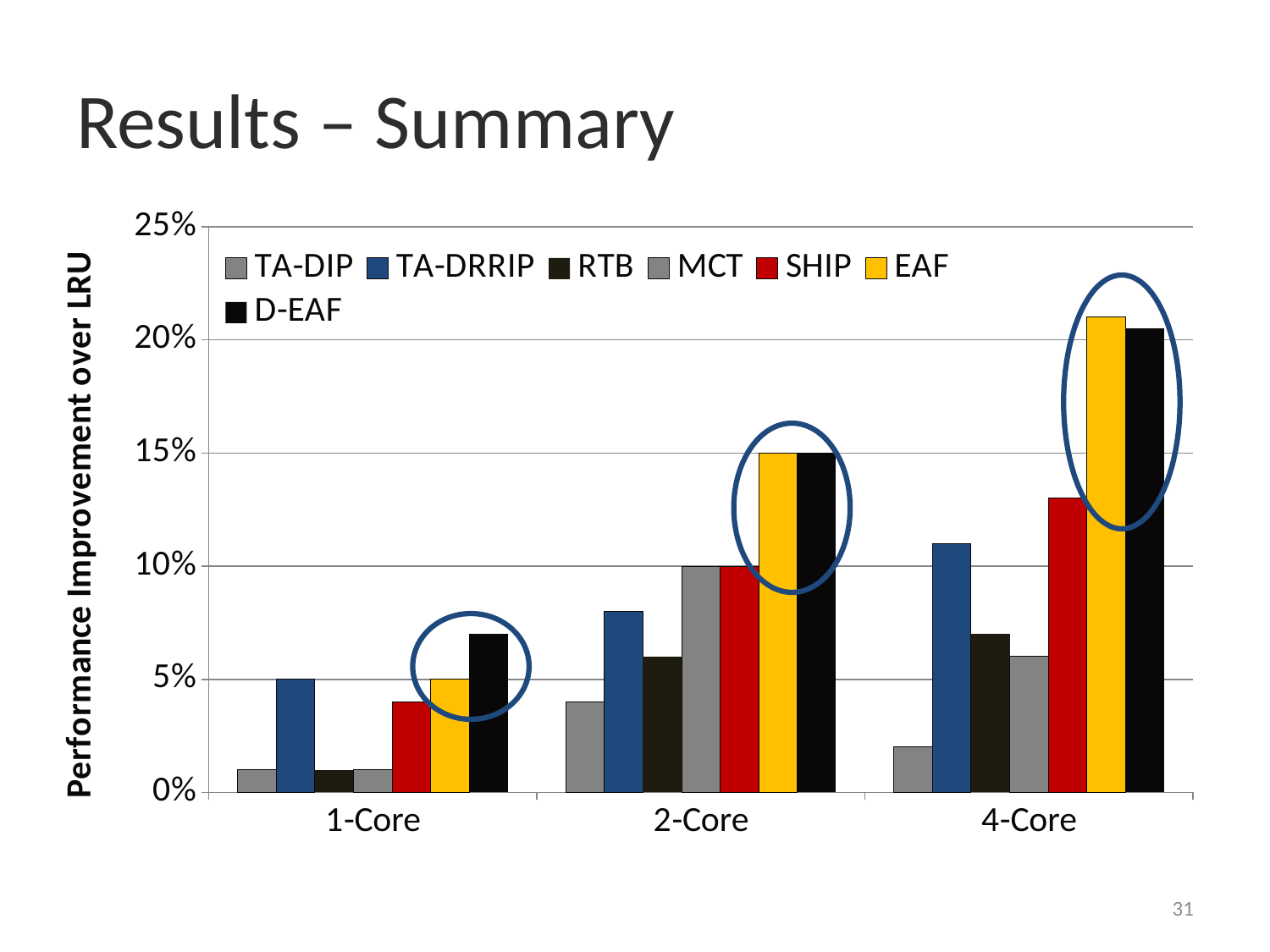
Which series has the highest value in the 4-Core category? EAF Which series has the lowest value in the 2-Core category? TA-DIP Do the values for D-EAF rise or fall from 1-Core to 4-Core? rise How many categories are shown on the x axis? 3 Which is larger in the 4-Core category, TA-DRRIP or SHIP? SHIP What type of chart is shown on the slide? bar chart How many series does the legend list? 7 What is the performance improvement over LRU for SHIP in the 2-Core category? 10% Is the value for EAF in the 4-Core category greater or less than 20%? greater Is the value for TA-DIP in the 4-Core category greater or less than 5%? less What is the performance improvement over LRU for TA-DRRIP in the 1-Core category? 5% What is the performance improvement over LRU for EAF in the 2-Core category? 15%